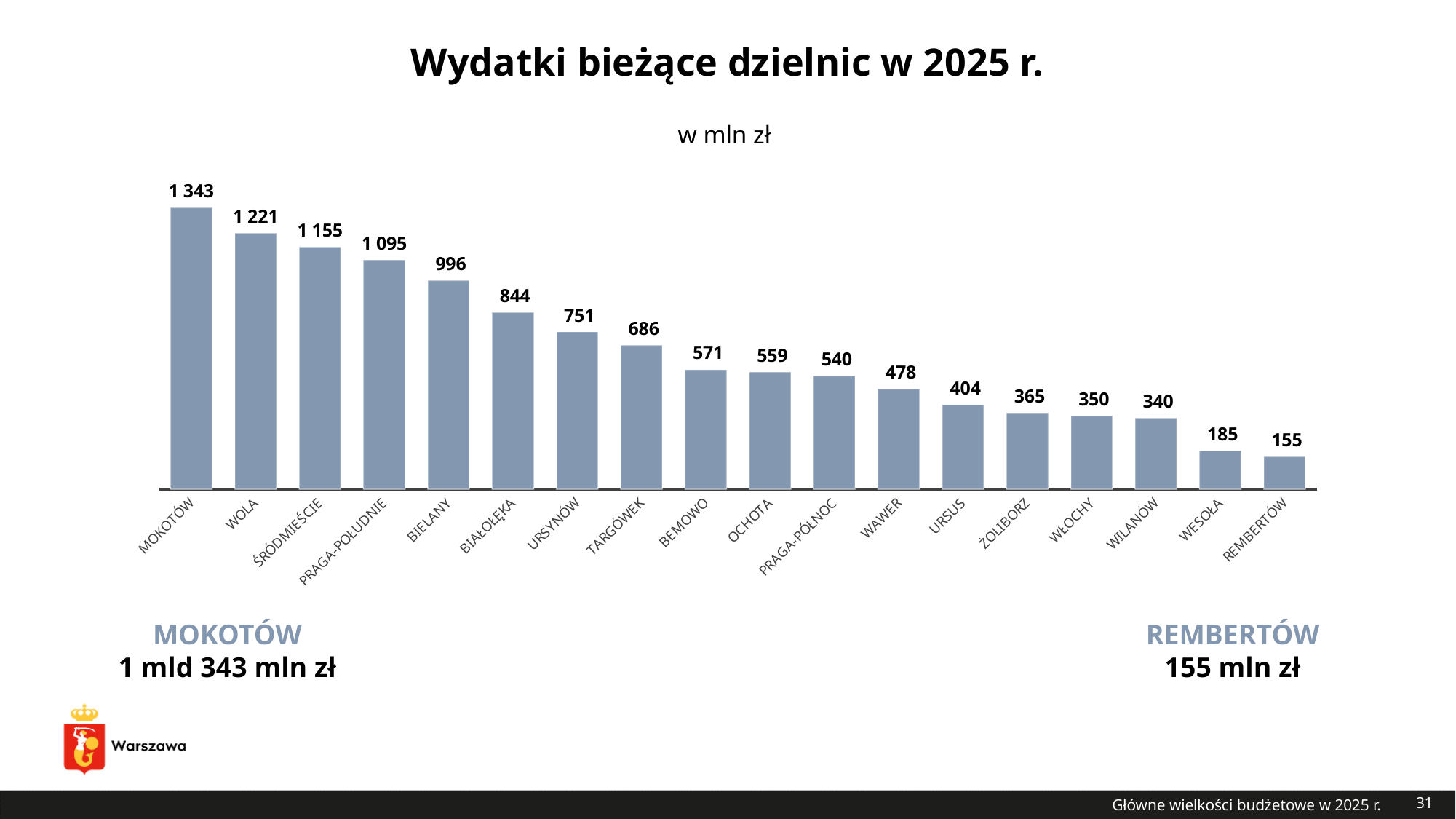
What is the difference between the values for Wesoła and Rembertów? 30 What is the title of the chart? Wydatki bieżące dzielnic w 2025 r. What is the value for Wilanów? 340 What is the difference between the values for Mokotów and Wola? 122 What is the value for Praga-Północ? 540 Do the values rise or fall from left to right along the x axis? Fall Which is larger, the value for Białołęka or the value for Ursynów? Białołęka What is the value for Bielany? 996 What kind of chart is shown on the slide? Bar chart Which district has the highest value? Mokotów Which district has the lowest value? Rembertów How many districts are shown in the chart? 18